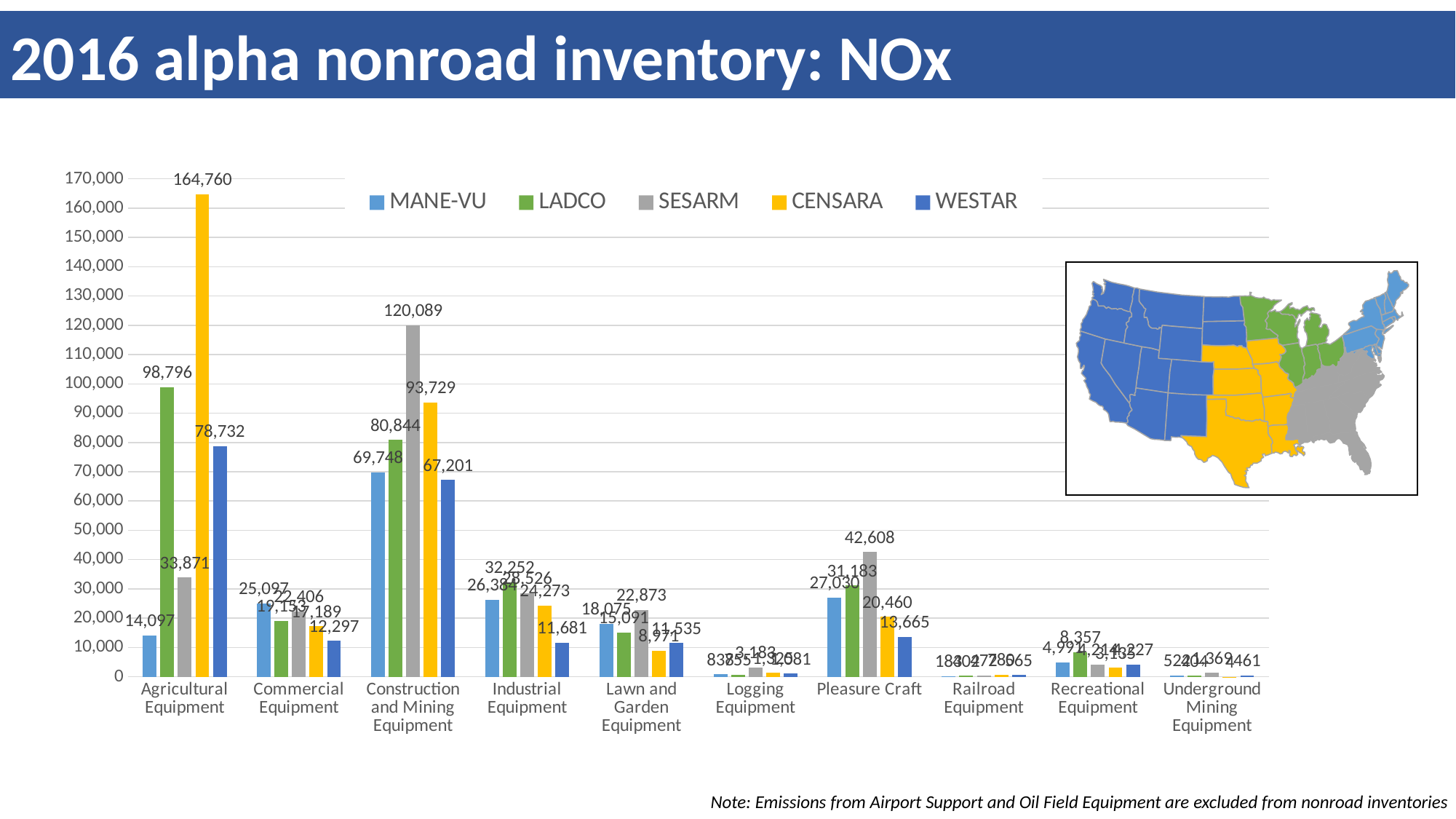
What kind of chart is shown on the slide? bar chart How many series does the legend list? 5 What is the LADCO value for Pleasure Craft? 31,183 What is the difference between the SESARM and MANE-VU values for Pleasure Craft? 15,578 Which region has the highest value for Agricultural Equipment? CENSARA How many equipment categories are shown on the x axis? 10 Which is larger for Lawn and Garden Equipment, the MANE-VU value or the LADCO value? MANE-VU What is the WESTAR value for Industrial Equipment? 11,681 What is the CENSARA value for Agricultural Equipment? 164,760 Is the LADCO value for Construction and Mining Equipment greater or less than 90,000? less What is the SESARM value for Construction and Mining Equipment? 120,089 Which region has the lowest value for Commercial Equipment? WESTAR